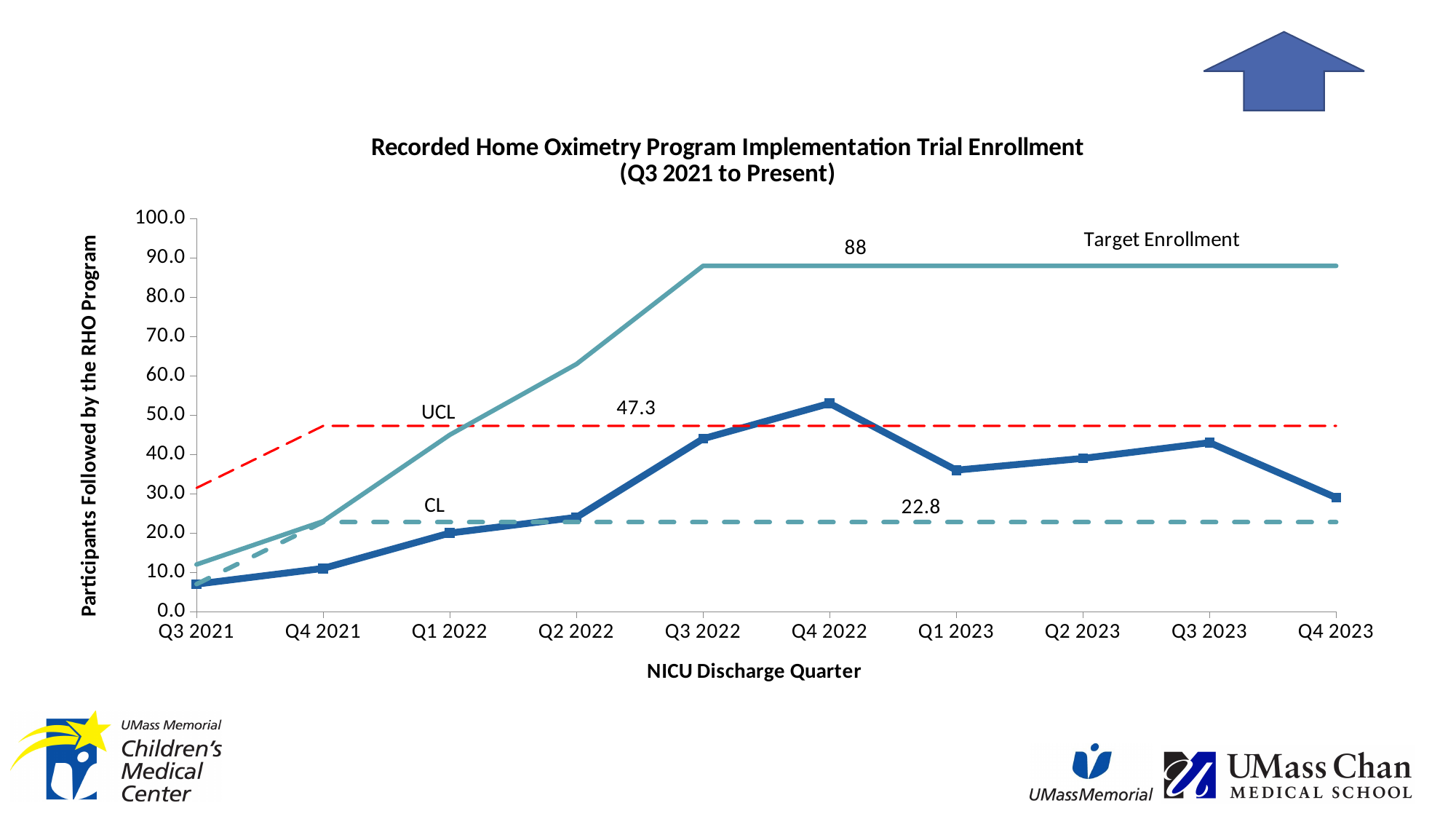
In which quarter is the participants line at its lowest point? Q3 2021 What kind of chart is shown on the slide? line chart What value does the Target Enrollment line reach from Q3 2022 onward? 88 Is the number of participants followed in Q3 2021 greater or less than 10? less Is the number of participants followed in Q4 2022 greater or less than 50? greater In which quarter does the participants line reach its highest point? Q4 2022 Which quarter has more participants followed, Q3 2023 or Q4 2023? Q3 2023 What is the value of the CL line? 22.8 What is the value of the UCL line? 47.3 What is the title of the x axis? NICU Discharge Quarter What is the difference between the UCL value and the CL value? 24.5 How many NICU discharge quarters are shown on the x axis? 10